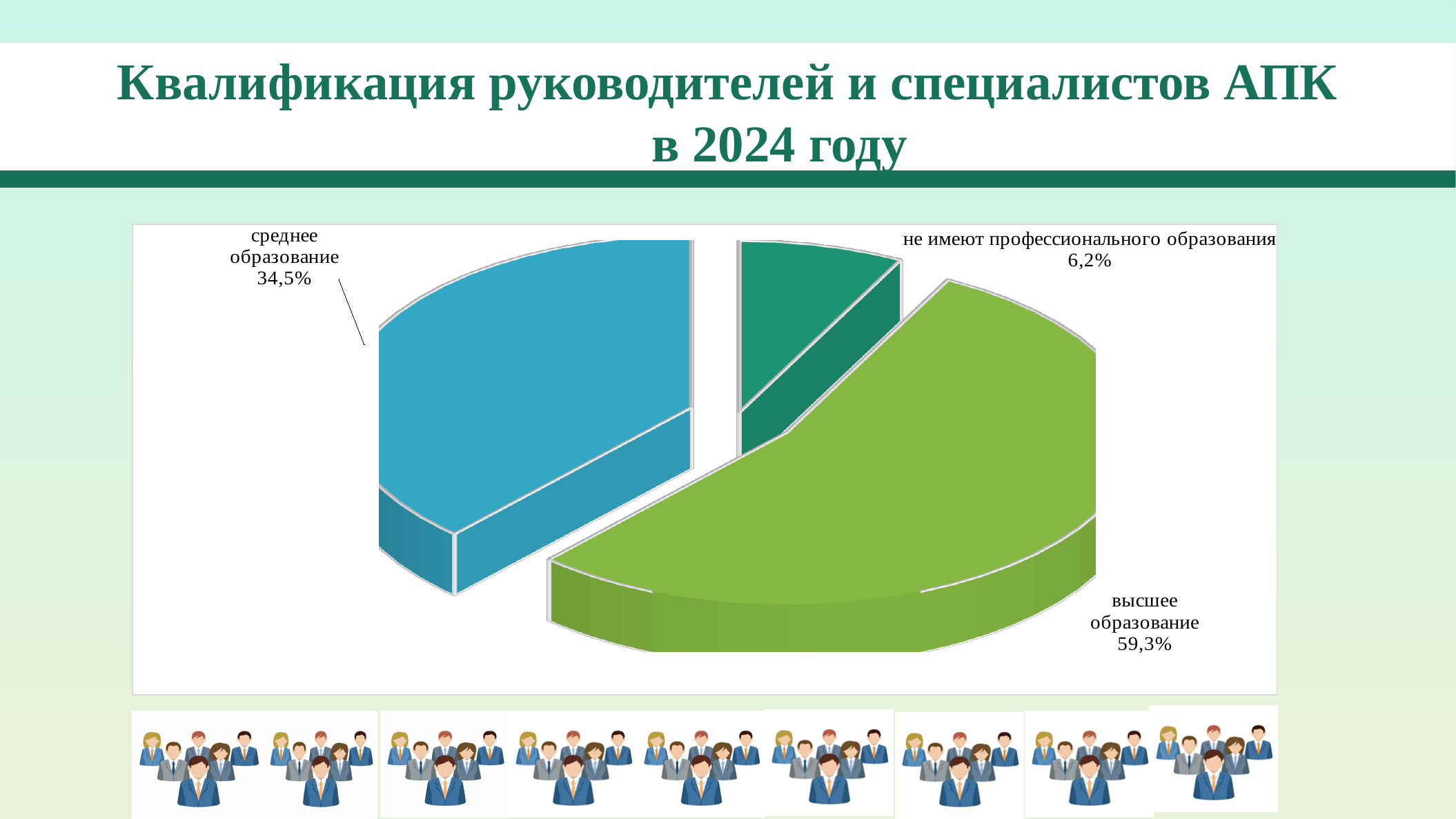
What is the difference in percentage points between "среднее образование" and "не имеют профессионального образования"? 28,3 What colour is the slice for "высшее образование"? green What share of the pie is labelled "высшее образование"? 59,3% What kind of chart is shown on the slide? pie chart What share of the pie is labelled "не имеют профессионального образования"? 6,2% What share of the pie is labelled "среднее образование"? 34,5% Which category has the largest slice of the pie? высшее образование Which is larger: the share for "среднее образование" or the share for "не имеют профессионального образования"? среднее образование What is the difference in percentage points between "высшее образование" and "среднее образование"? 24,8 How many slices does the pie chart have? 3 What is the title of the slide containing the chart? Квалификация руководителей и специалистов АПК в 2024 году Which category has the smallest slice of the pie? не имеют профессионального образования